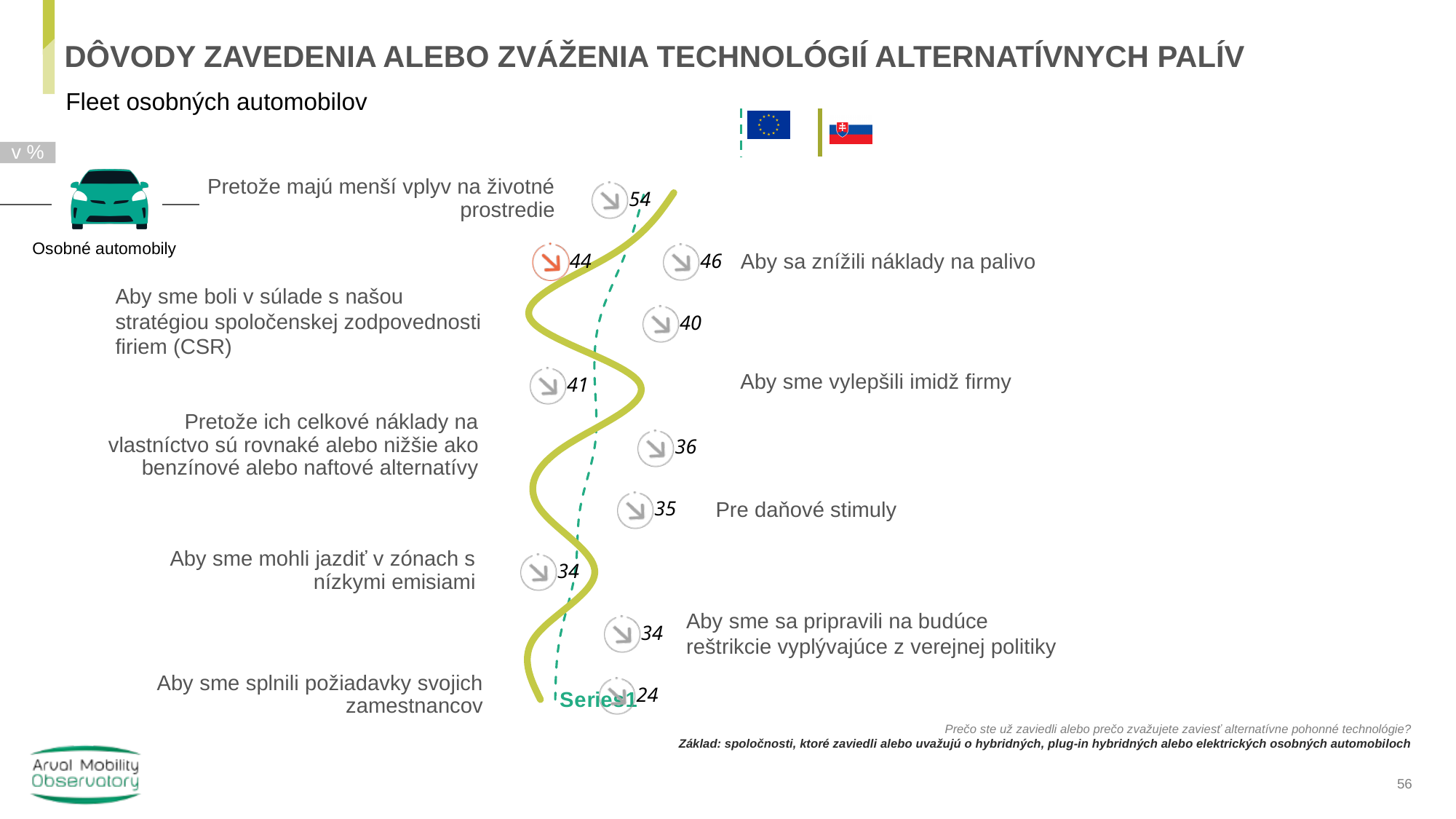
What is the difference between the highest value (54) and the lowest value (24) on the chart? 30 What value is shown for "Pretože majú menší vplyv na životné prostredie"? 54 What kind of chart is shown on the slide? Line chart What value is shown for "Aby sme splnili požiadavky svojich zamestnancov"? 24 Which has a larger value: "Aby sa znížili náklady na palivo" or "Pre daňové stimuly"? Aby sa znížili náklady na palivo What value is shown for "Aby sme sa pripravili na budúce reštrikcie vyplývajúce z verejnej politiky"? 34 What is the highest value shown on the chart? 54 What value is shown for "Aby sa znížili náklady na palivo"? 46 In what unit are the chart values expressed, according to the label at the top left? v % What series name is printed at the bottom of the chart? Series1 What value is shown for "Pre daňové stimuly"? 35 What is the lowest value shown on the chart? 24